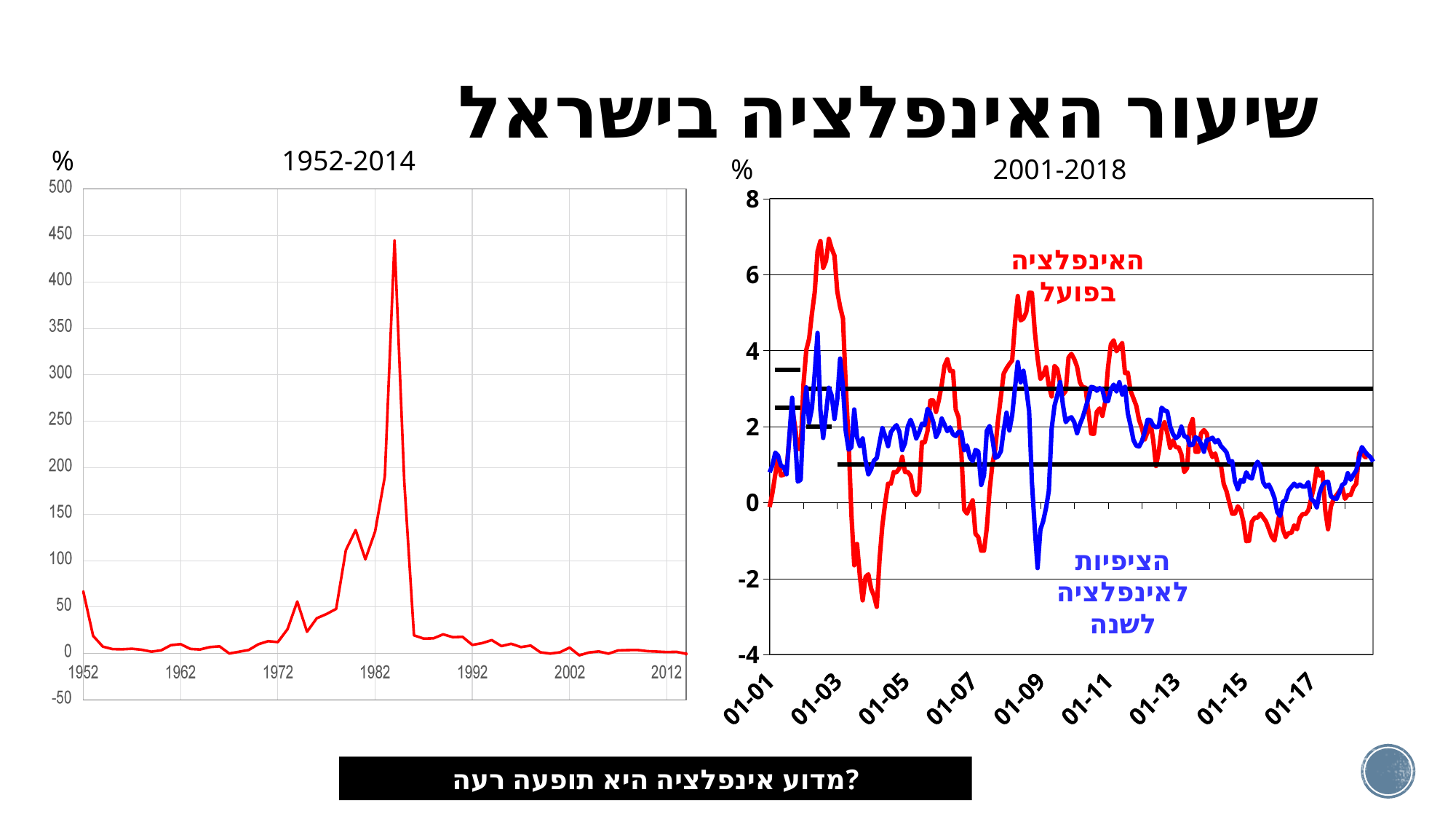
In the right chart (2001-2018), is the peak of the red line near 01-03 greater or less than 6? greater What kind of chart is the left chart titled 1952-2014? line chart In the left chart (1952-2014), is the value at 2012 greater or less than 50? less In the left chart (1952-2014), is the value at 1952 greater or less than 100? less In the right chart (2001-2018), what colour is the line labelled האינפלציה בפועל? red In the left chart (1952-2014), does the line generally rise or fall between 1992 and 2012? fall In the left chart (1952-2014), between which two x-axis labels does the peak of the line occur? 1982 and 1992 How many data series are plotted in the right chart (2001-2018)? 4 What kind of chart is the right chart titled 2001-2018? line chart